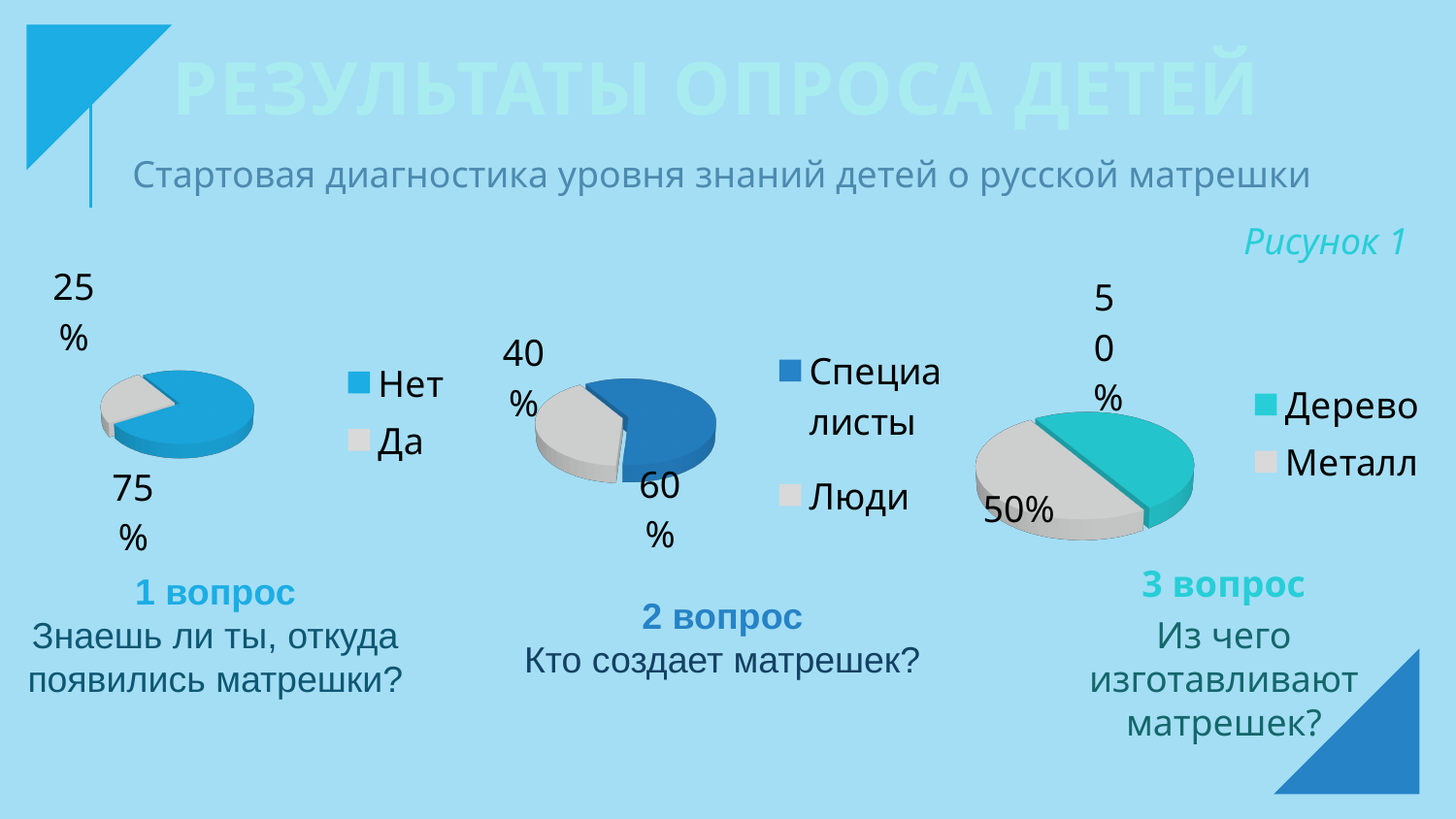
In the left pie chart (1 вопрос), what share of children answered "Нет"? 75% In the right pie chart (3 вопрос), how many categories does the legend list? 2 In the middle pie chart (2 вопрос), what share is labelled "Специалисты"? 60% In the left pie chart (1 вопрос), what share of children answered "Да"? 25% In the left pie chart (1 вопрос), what is the difference between the "Нет" and "Да" shares? 50% In the middle pie chart (2 вопрос), what is the difference between the "Специалисты" and "Люди" shares? 20% In the middle pie chart (2 вопрос), which is larger: "Специалисты" or "Люди"? Специалисты In the middle pie chart (2 вопрос), what share is labelled "Люди"? 40% In the left pie chart (1 вопрос), which answer has the larger share? Нет What type of chart is used for the three charts on the slide? Pie chart In the right pie chart (3 вопрос), what are the two legend entries? Дерево, Металл In the right pie chart (3 вопрос), what share is labelled "Дерево"? 50%